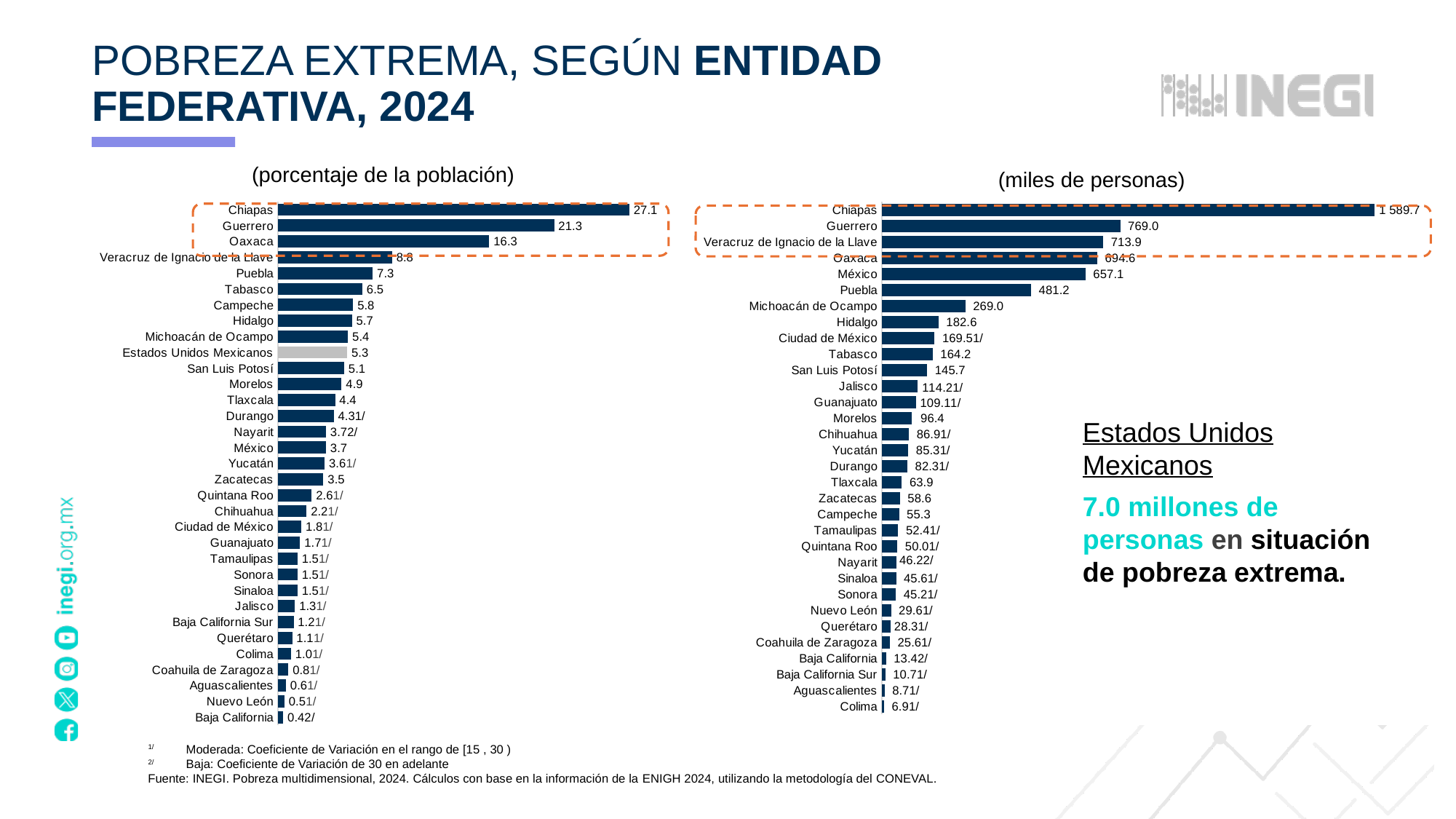
In the chart titled '(porcentaje de la población)', what is the value for Chiapas? 27.1 In the chart titled '(miles de personas)', which entity has the highest value? Chiapas In the chart titled '(porcentaje de la población)', what is the difference between the values for Chiapas and Guerrero? 5.8 In the chart titled '(miles de personas)', which is larger, the value for Veracruz de Ignacio de la Llave or the value for Oaxaca? Veracruz de Ignacio de la Llave How many bars are shown in the chart titled '(miles de personas)'? 32 In the chart titled '(miles de personas)', which entity has the lowest value? Colima In the chart titled '(porcentaje de la población)', what is the value for Estados Unidos Mexicanos? 5.3 In the chart titled '(porcentaje de la población)', which is larger, the value for Tabasco or the value for Campeche? Tabasco In the chart titled '(miles de personas)', what is the value for Puebla? 481.2 In the chart titled '(miles de personas)', what is the value for Guerrero? 769.0 What kind of chart is the chart titled '(porcentaje de la población)'? Bar chart In the chart titled '(porcentaje de la población)', which entity has the lowest value? Baja California